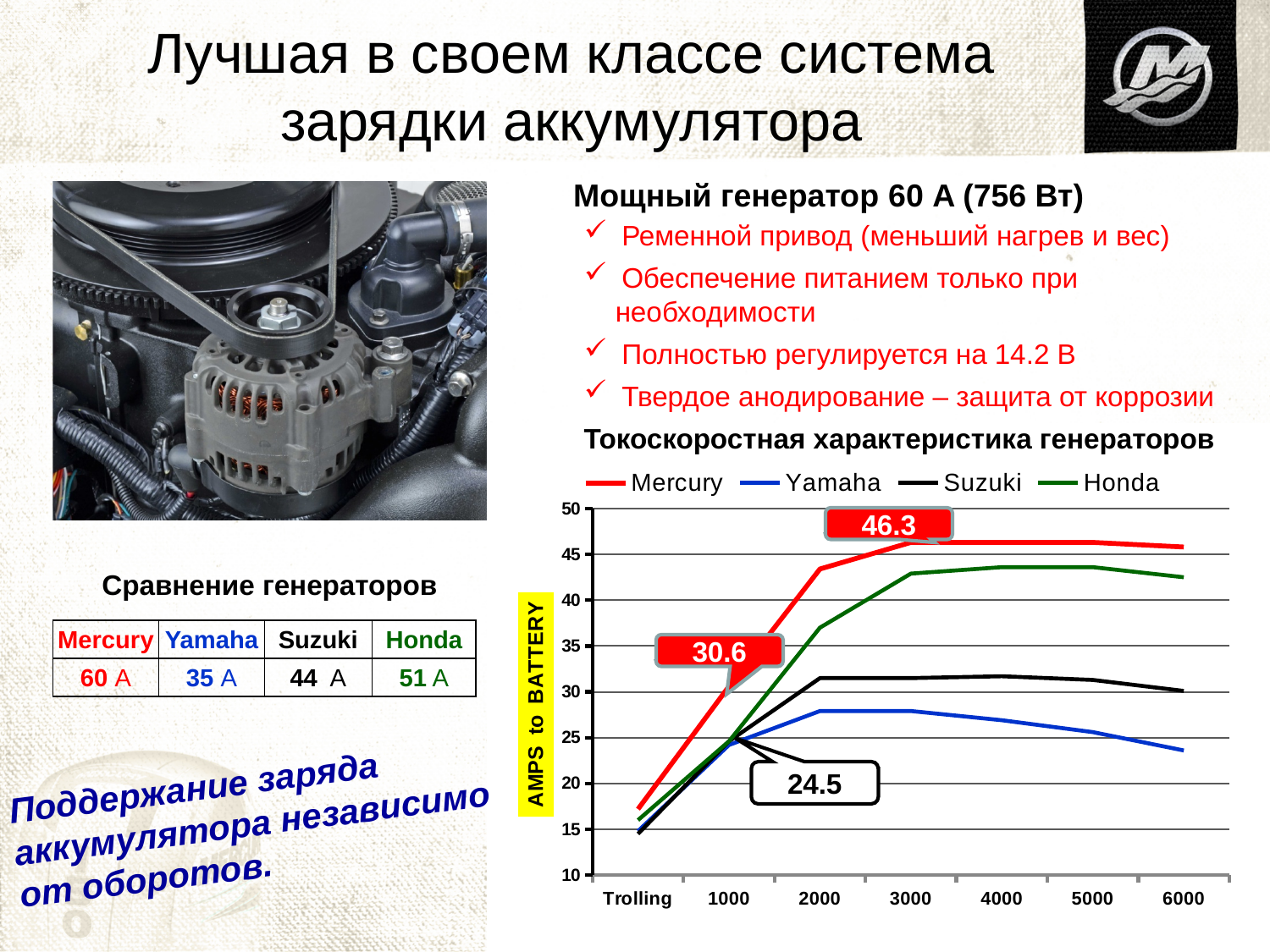
What is the title of the y axis of the line chart? AMPS to BATTERY In the line chart, by how much does the Mercury value at 3000 exceed the Mercury value at 1000? 15.7 Which series has the lowest value at 6000 in the line chart? Yamaha Which series has the highest value at 6000 in the line chart? Mercury What is the labelled value for Mercury at 1000 in the line chart? 30.6 How many categories are shown on the x axis of the line chart? 7 How many series does the legend of the line chart list? 4 Is the value for Honda at 3000 greater or less than 40? greater What kind of chart is shown under the heading 'Токоскоростная характеристика генераторов'? line chart Which is larger at 4000 in the line chart, Suzuki or Yamaha? Suzuki What is the labelled value for Mercury at 3000 in the line chart? 46.3 What is the labelled value for Suzuki at 1000 in the line chart? 24.5